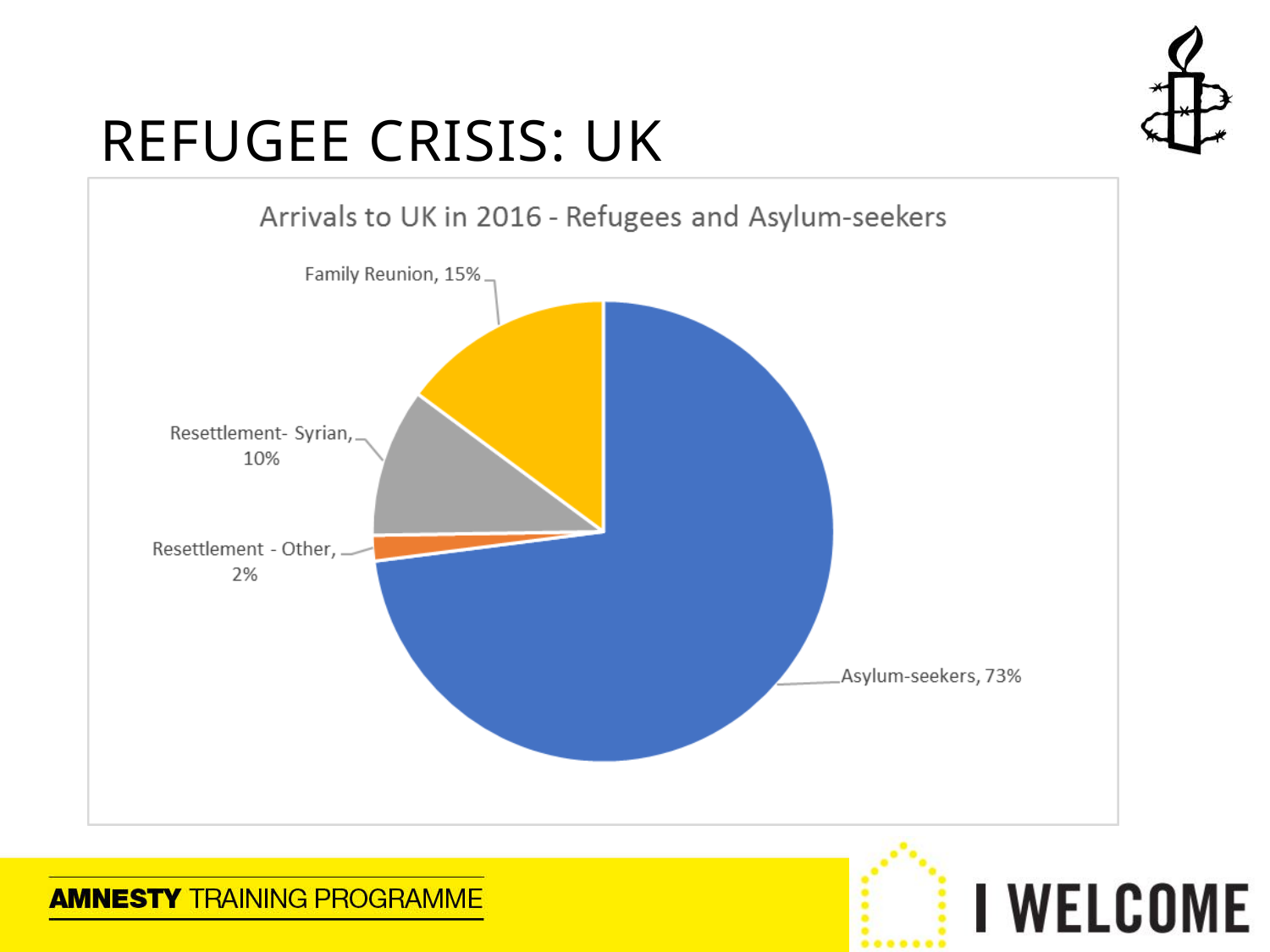
What share of arrivals is labelled as Family Reunion? 15% What share of arrivals is labelled as Resettlement - Other? 2% How many slices does the pie chart have? 4 What share of arrivals is labelled as Asylum-seekers? 73% What colour is the Asylum-seekers slice? Blue Which category has the largest slice of the pie? Asylum-seekers Which category has the smallest slice of the pie? Resettlement - Other What is the title of the chart? Arrivals to UK in 2016 - Refugees and Asylum-seekers Which is larger, the Family Reunion slice or the Resettlement- Syrian slice? Family Reunion What kind of chart is shown on the slide? Pie chart What is the difference in percentage points between Family Reunion and Resettlement- Syrian? 5